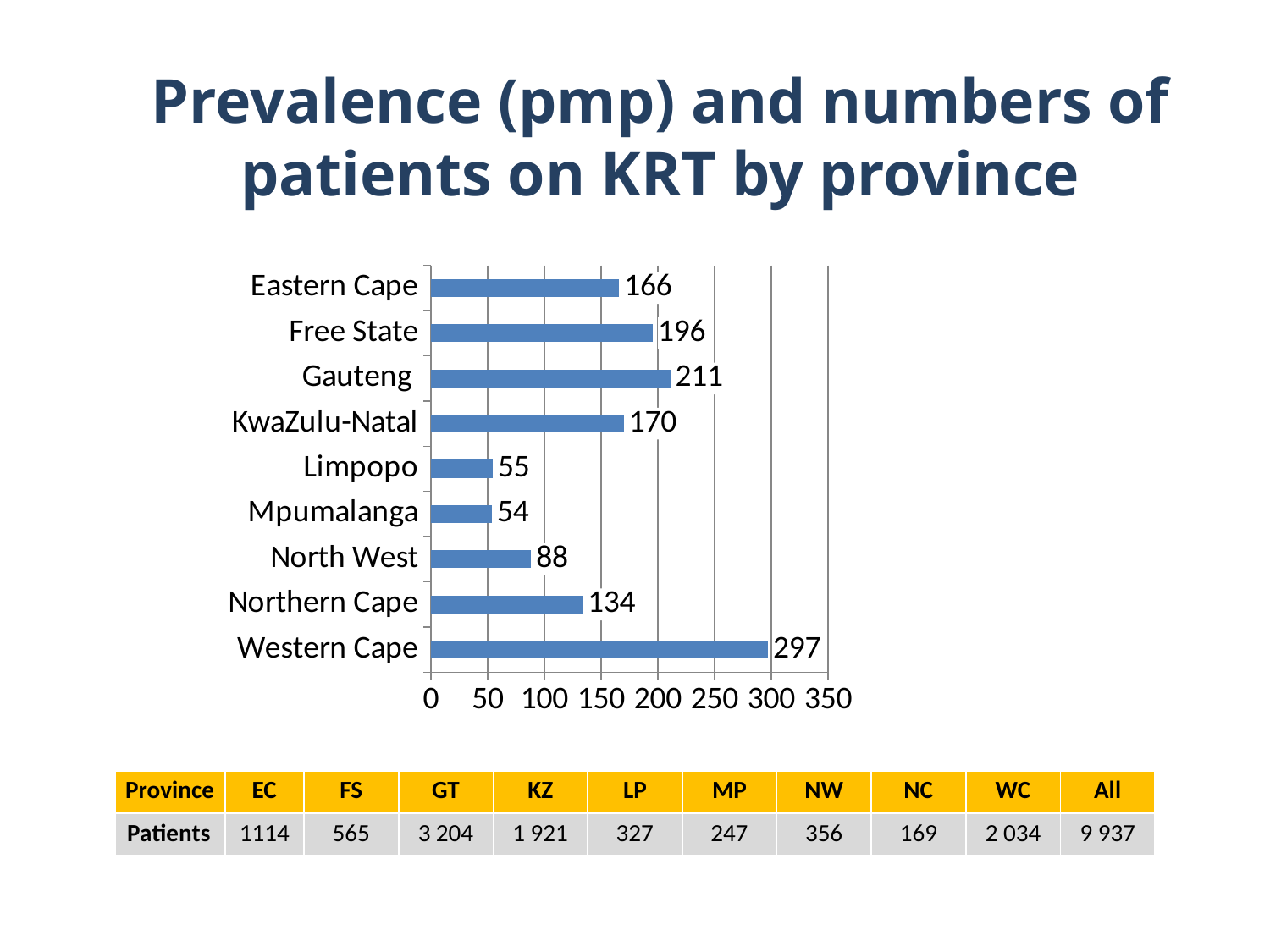
What is the maximum value shown on the horizontal axis of the chart? 350 Which province has the lowest prevalence (pmp) in the chart? Mpumalanga What kind of chart is shown on the slide? Bar chart How many provinces are shown in the chart? 9 What is the prevalence (pmp) value for North West? 88 Which province has the highest prevalence (pmp) in the chart? Western Cape What is the difference between the prevalence values for Western Cape and Gauteng? 86 What is the prevalence (pmp) value for Western Cape? 297 What is the prevalence (pmp) value for Gauteng? 211 Is the prevalence value for Northern Cape greater or less than 150? less What is the difference between the prevalence values for Free State and Eastern Cape? 30 Which has a higher prevalence (pmp), KwaZulu-Natal or Northern Cape? KwaZulu-Natal